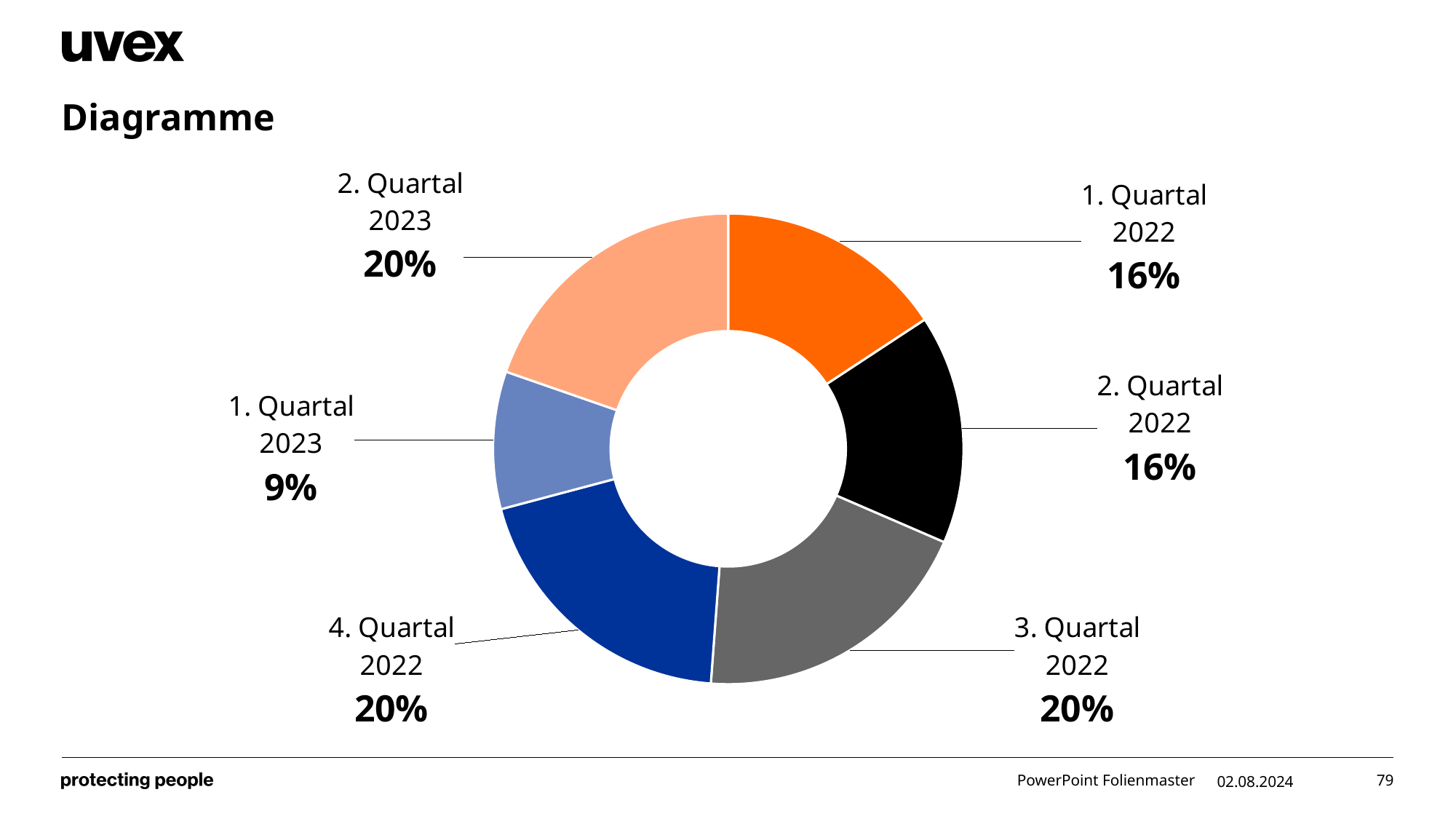
What percentage does the 1. Quartal 2023 slice show? 9% What kind of chart is shown on the slide? Doughnut (pie) chart What is the difference in percentage points between the 1. Quartal 2022 slice and the 1. Quartal 2023 slice? 7% What percentage does the 2. Quartal 2023 slice show? 20% How many slices does the chart have? 6 What percentage does the 1. Quartal 2022 slice show? 16% What is the title of the slide containing the chart? Diagramme Which is larger, the 4. Quartal 2022 slice or the 2. Quartal 2022 slice? 4. Quartal 2022 Which is larger, the 1. Quartal 2023 slice or the 2. Quartal 2023 slice? 2. Quartal 2023 What percentage does the 3. Quartal 2022 slice show? 20% Which slice has the smallest share of the chart? 1. Quartal 2023 What share of the chart does the 2. Quartal 2022 slice represent? 16%